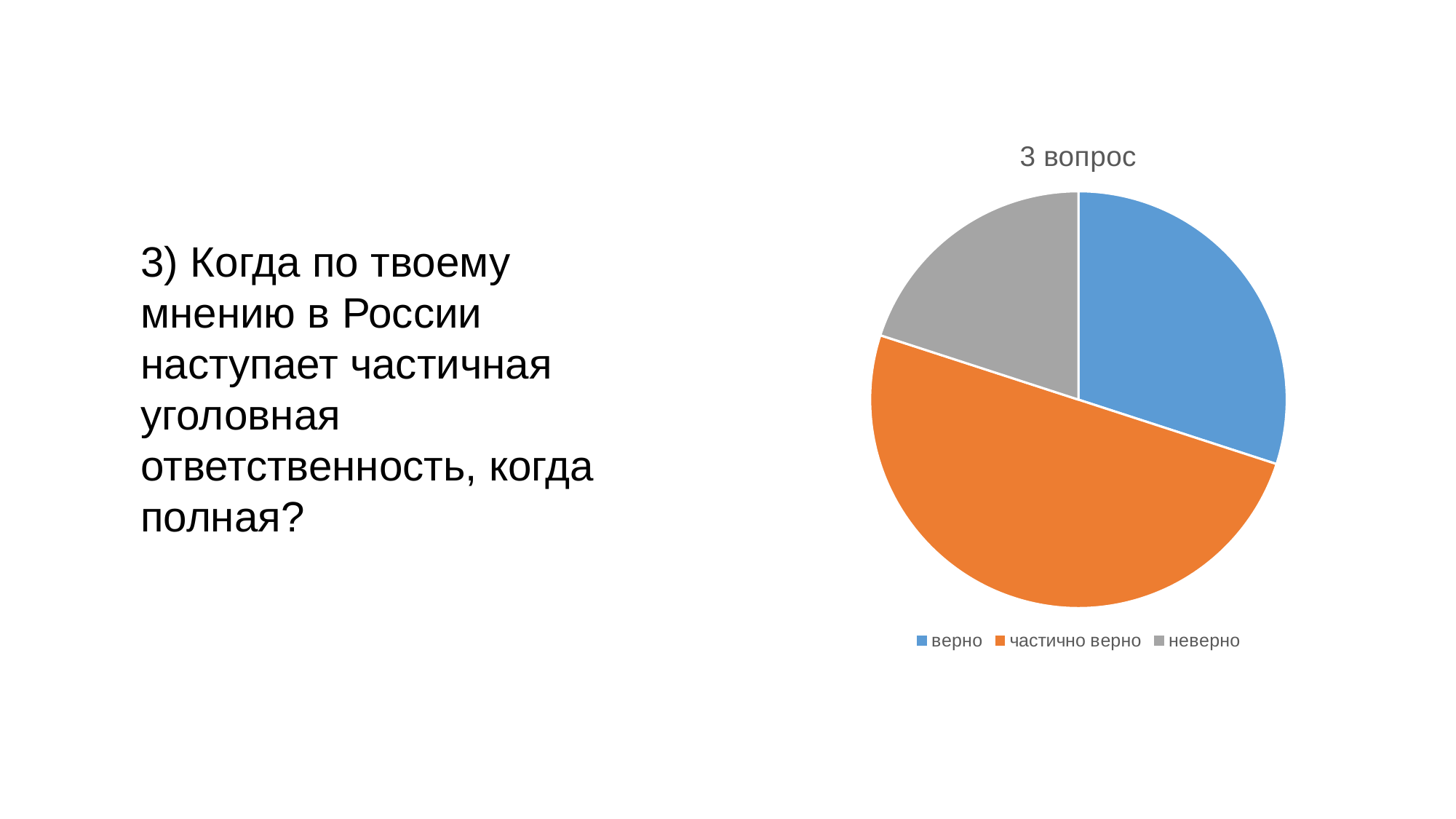
How many entries does the chart legend list? 3 Which slice is larger, частично верно or верно? частично верно What kind of chart is shown on the slide? pie chart Which category has the smallest slice of the pie? неверно Which category has the largest slice of the pie? частично верно Which slice is larger, верно or неверно? верно Is the share of the slice неверно greater or less than a quarter of the pie? less How many slices does the pie chart have? 3 What is the title of the chart? 3 вопрос Which colour represents the category частично верно? orange